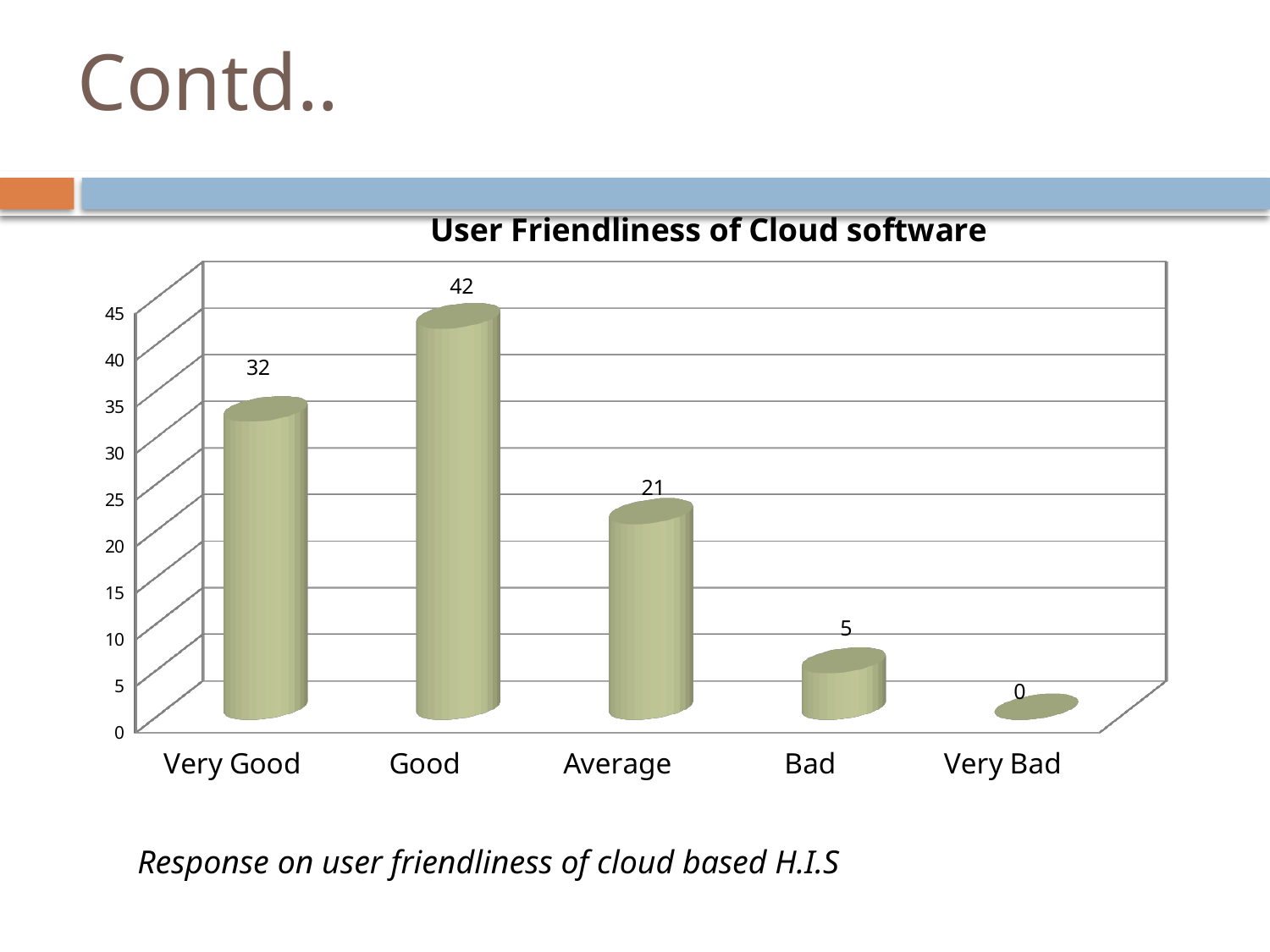
What is the value for Very Bad? 0 What is the difference between the values for Good and Very Good? 10 What is the value for Good? 42 What is the value for Very Good? 32 What kind of chart is shown? Bar chart Which category has the lowest value? Very Bad What is the title of the chart? User Friendliness of Cloud software What is the value for Average? 21 How many categories are shown on the x axis? 5 Which category has the highest value? Good Which is larger, the value for Average or the value for Bad? Average What is the value for Bad? 5